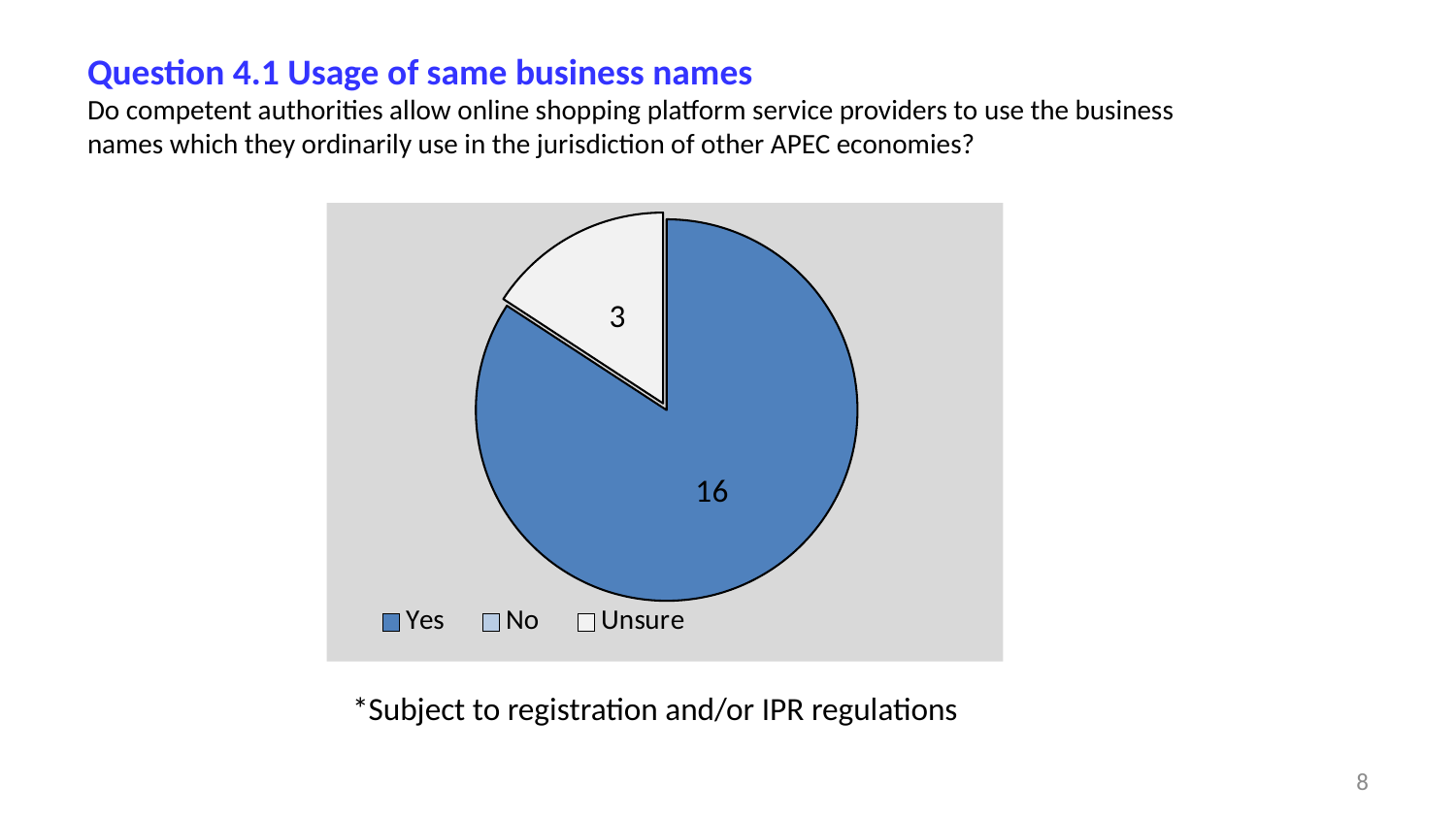
What value is shown for the Yes slice of the pie chart? 16 What is the difference between the Yes value and the Unsure value in the pie chart? 13 What kind of chart is shown on the slide? Pie chart How many entries does the legend of the pie chart list? 3 Which legend entry is shown in dark blue? Yes What value is shown for the Unsure slice of the pie chart? 3 Which category has the largest slice in the pie chart? Yes How many slices are visible in the pie chart? 2 What are the three legend entries of the pie chart? Yes, No, Unsure Which of the labelled slices, Yes or Unsure, is larger? Yes